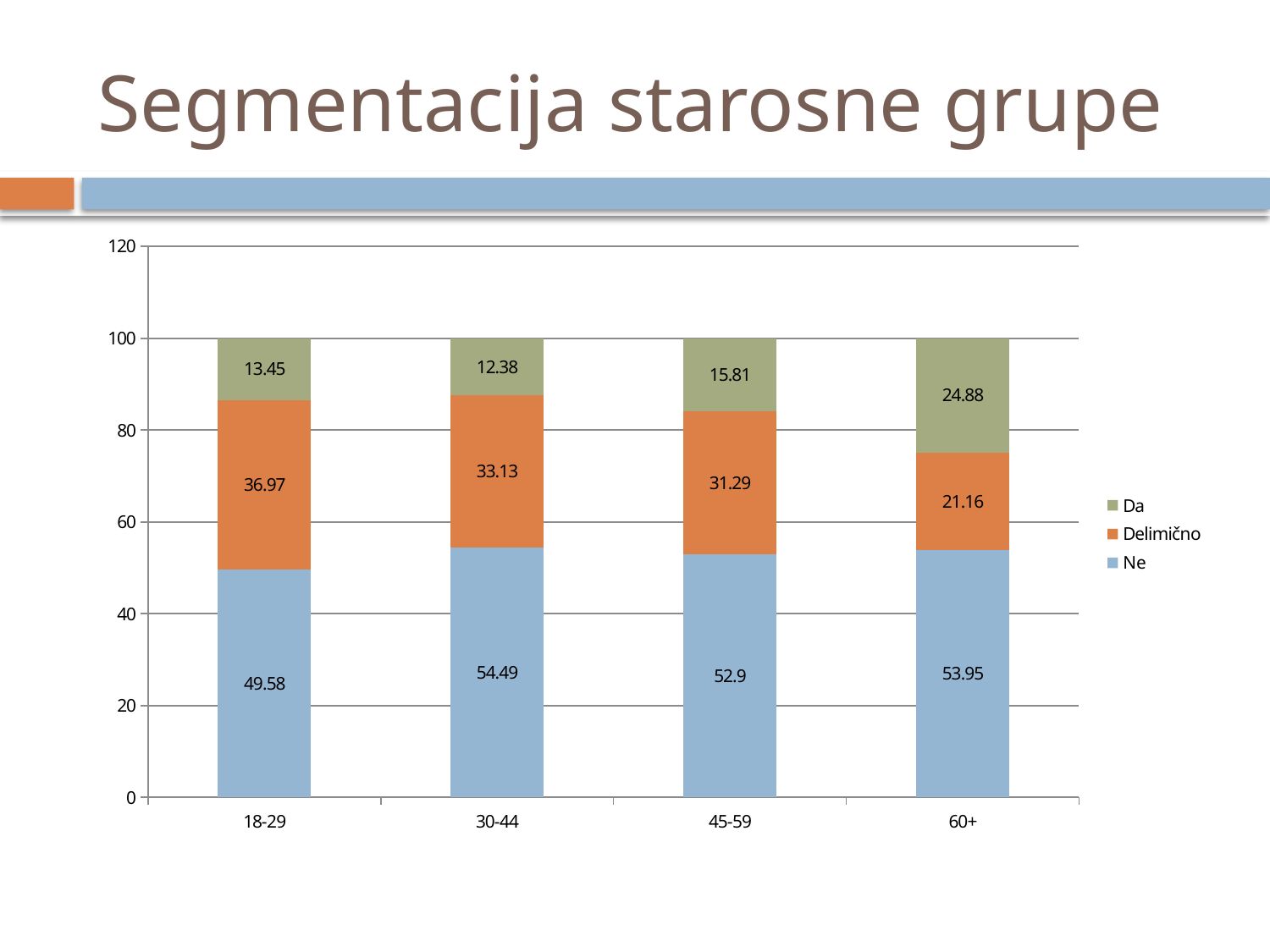
Which age group has the lowest 'Ne' value? 18-29 How many age groups are shown on the x axis? 4 What is the value of 'Delimično' for the 45-59 age group? 31.29 Is the 'Da' value larger for 45-59 or for 30-44? 45-59 Which age group has the lowest 'Delimično' value? 60+ Which age group has the highest 'Da' value? 60+ What is the value of 'Da' for the 60+ age group? 24.88 What type of chart is shown on the slide? Stacked bar chart What is the value of 'Ne' for the 30-44 age group? 54.49 What is the difference between the 'Delimično' values for 18-29 and 60+? 15.81 How many series does the legend list? 3 What is the total of the stacked bar for the 18-29 age group? 100